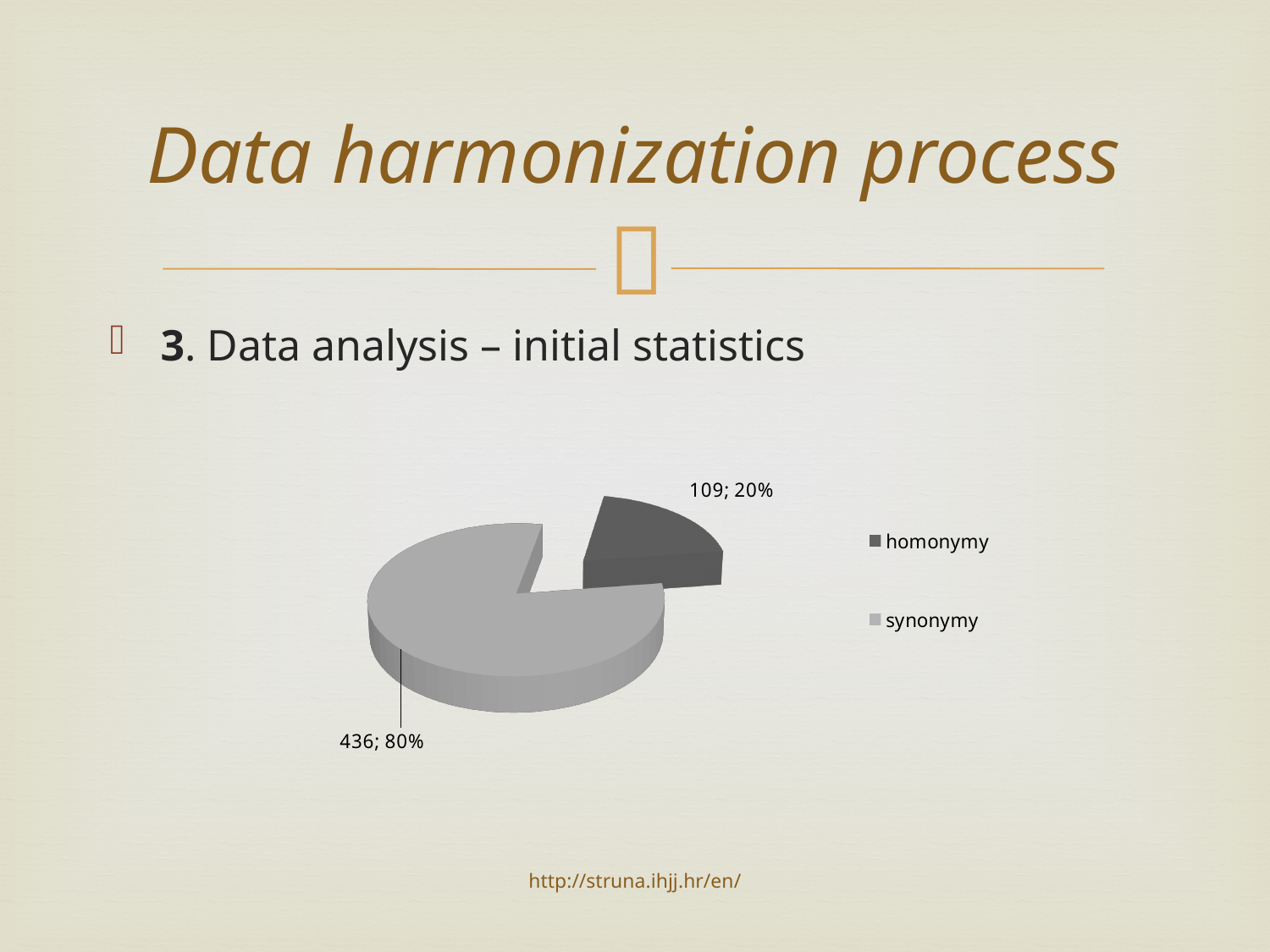
Which category has the largest slice? synonymy How many categories does the pie chart have? 2 What is the total of the two values shown in the pie chart? 545 What share of the pie does synonymy represent? 80% What is the value for synonymy? 436 What kind of chart is shown on the slide? pie chart What is the value for homonymy? 109 Which is larger, the value for homonymy or the value for synonymy? synonymy What is the difference between the values for synonymy and homonymy? 327 Which legend entry is shown in the darker grey colour? homonymy Which category has the smallest slice? homonymy What share of the pie does homonymy represent? 20%